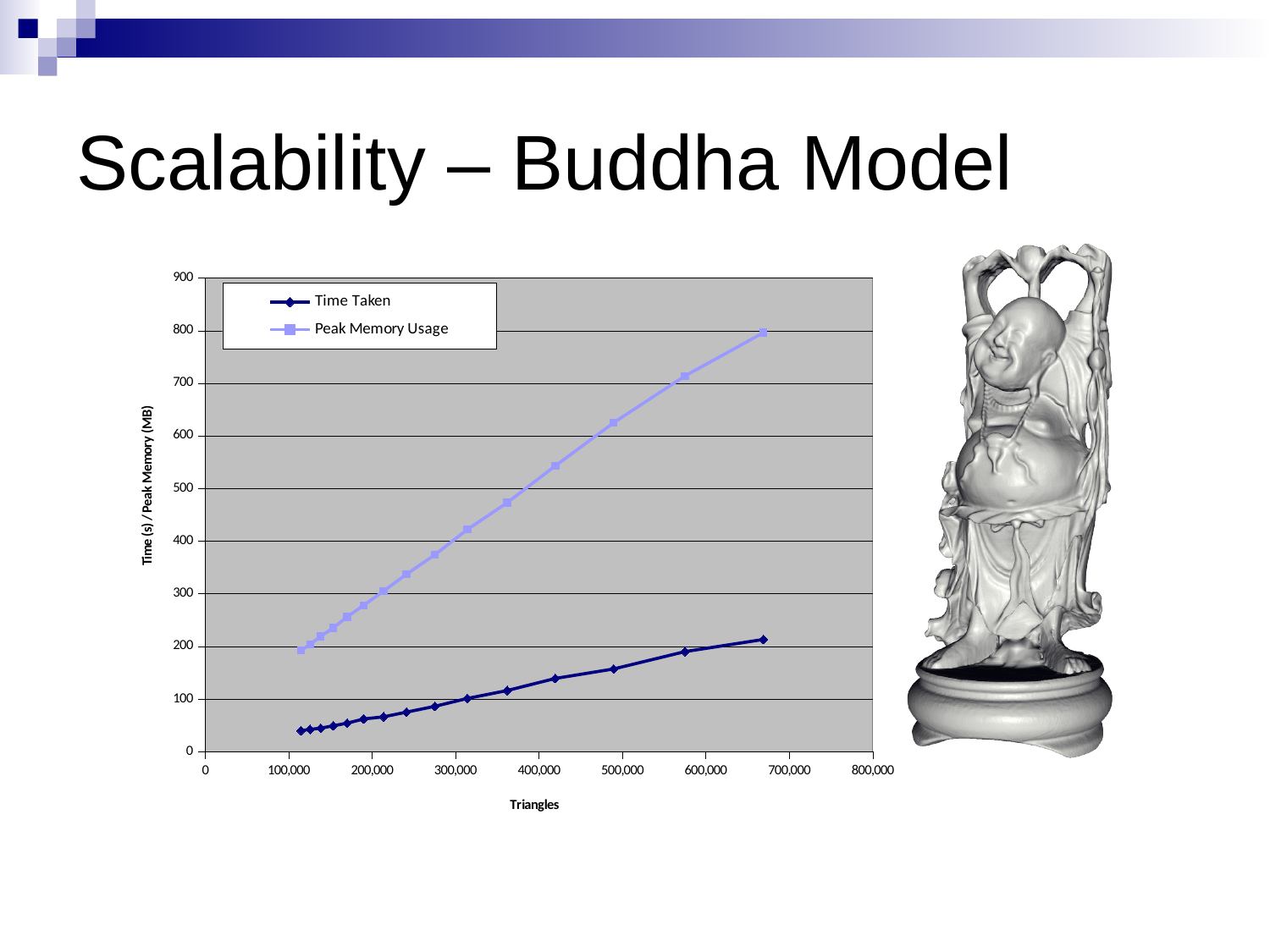
Does the Time Taken series rise or fall as the number of triangles increases? rise Is the Peak Memory Usage value at the leftmost point (around 115,000 triangles) greater or less than 300? less Is the Peak Memory Usage value at around 420,000 triangles greater or less than 500? greater How many series does the legend list? 2 Does the Peak Memory Usage series rise or fall as the number of triangles increases? rise What is the label of the x axis? Triangles What kind of chart is shown on the slide? line chart Is the Time Taken value at around 490,000 triangles greater or less than 200? less What are the two series named in the legend? Time Taken and Peak Memory Usage Which series has the higher values across the chart, Time Taken or Peak Memory Usage? Peak Memory Usage